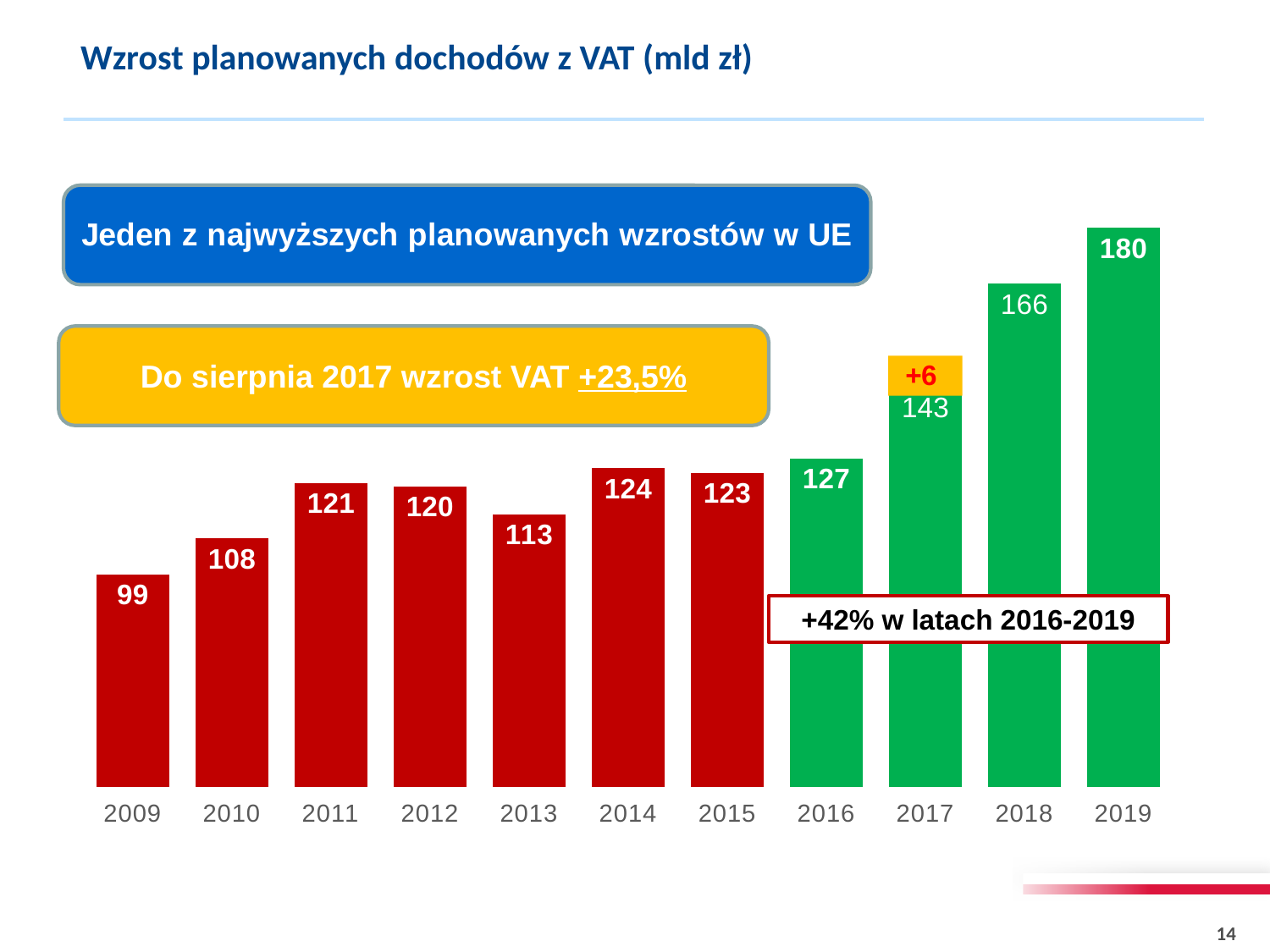
Which year has the highest value? 2019 Do the values generally rise or fall from 2016 to 2019? rise What value is shown on the yellow segment on top of the 2017 bar? +6 What kind of chart is shown on the slide? bar chart What is the value for 2014? 124 Which is larger, the value for 2011 or the value for 2013? 2011 What is the title of the chart? Wzrost planowanych dochodów z VAT (mld zł) Which year has the lowest value? 2009 What is the value for 2019? 180 How many years are shown on the x axis? 11 What is the difference between the values for 2018 and 2016? 39 What is the value for 2009? 99